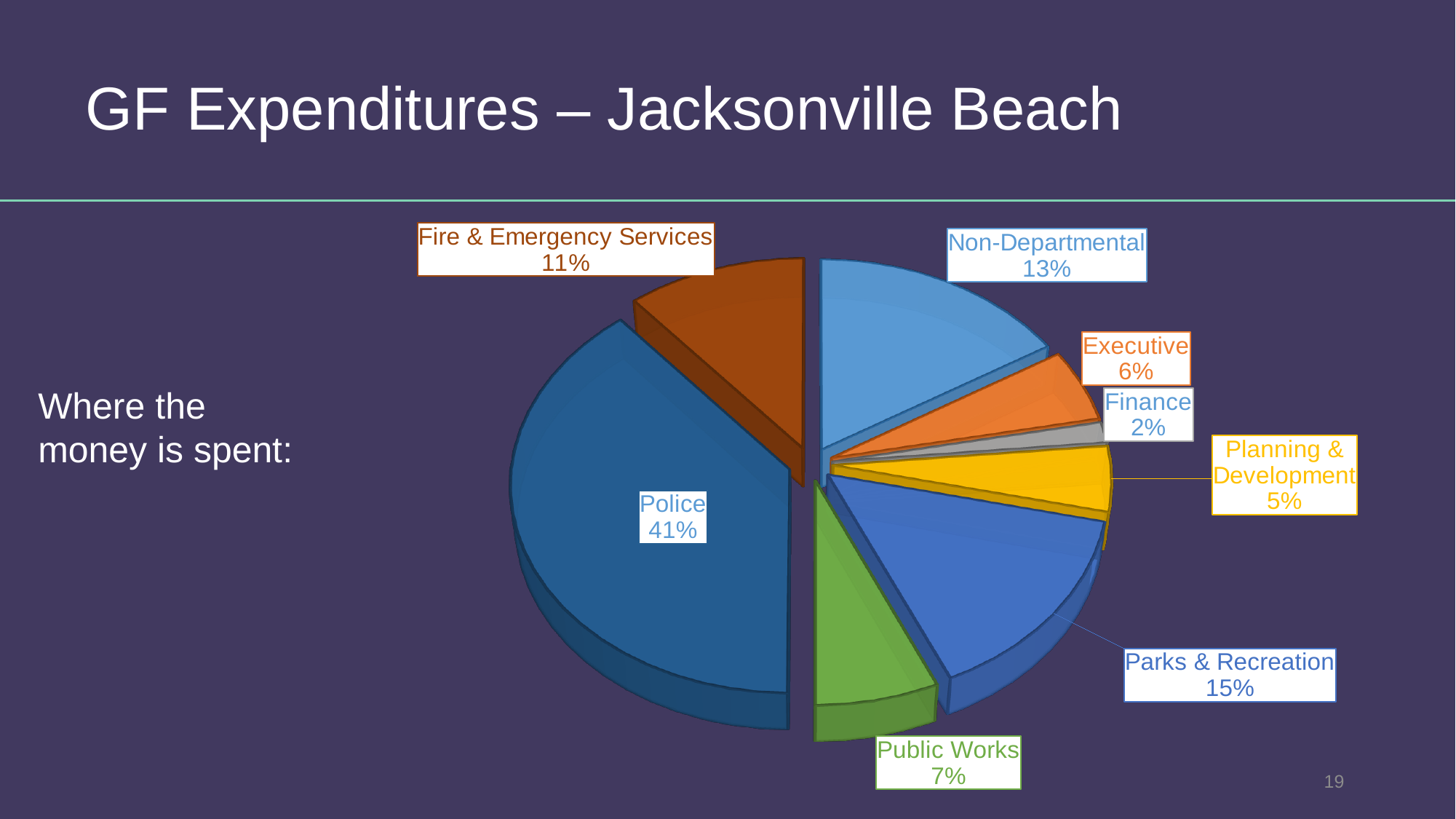
What percentage is shown for Non-Departmental? 13% What is the difference in percentage points between Police and Parks & Recreation? 26 What percentage is shown for Parks & Recreation? 15% What percentage is shown for Planning & Development? 5% Which category has the smallest share of expenditures? Finance What is the title of the slide containing the chart? GF Expenditures – Jacksonville Beach Which category has the largest share of expenditures? Police Which is larger, the share for Executive or the share for Public Works? Public Works What percentage is shown for Fire & Emergency Services? 11% How many categories are shown in the pie chart? 8 What share of GF expenditures goes to Police? 41% What kind of chart is shown on the slide? Pie chart